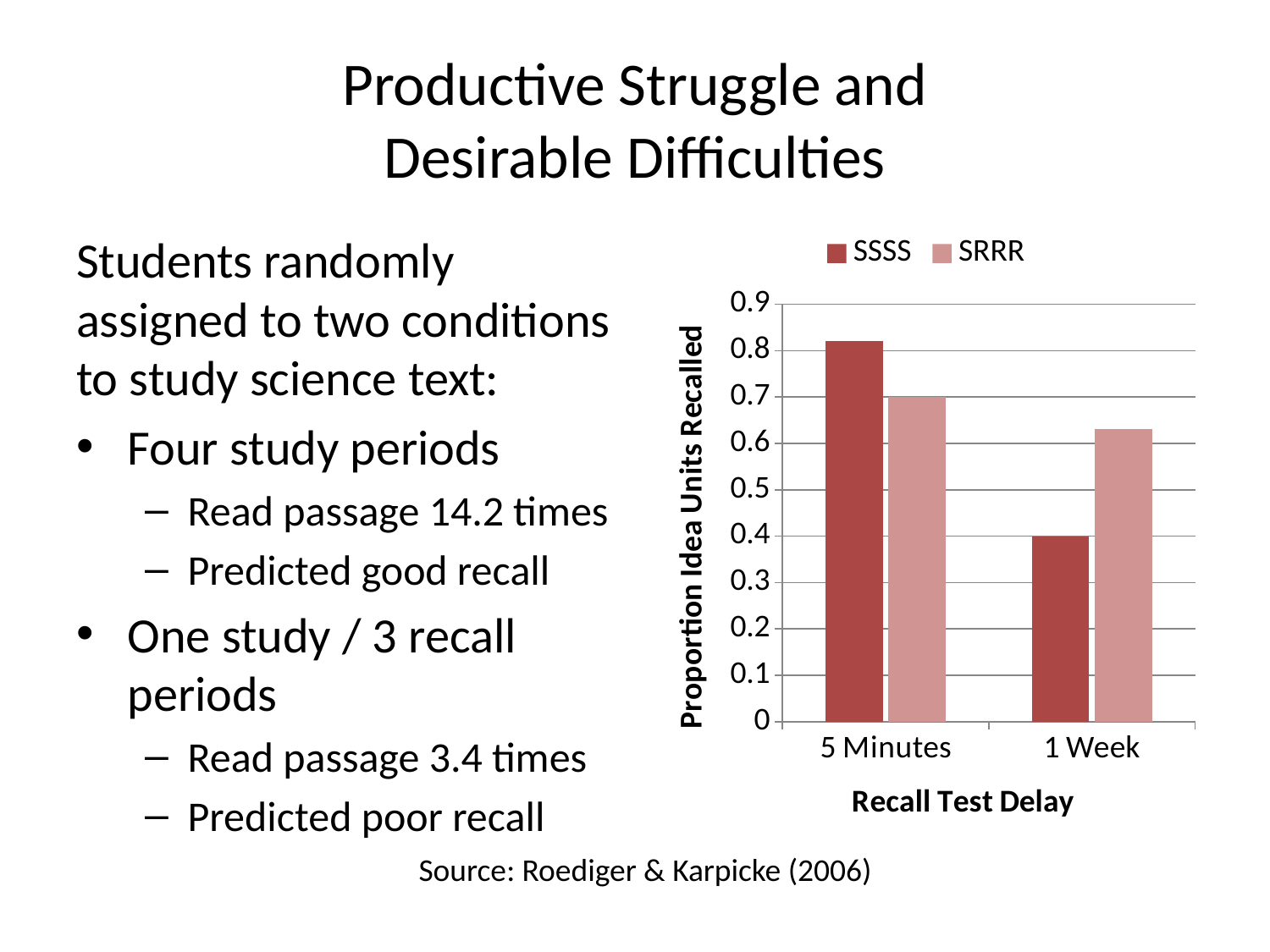
What is the value for SRRR at 5 Minutes? 0.7 At 1 Week, which series has the larger value, SSSS or SRRR? SRRR Is the value for SSSS at 5 Minutes greater or less than 0.8? greater At 5 Minutes, which series has the larger value, SSSS or SRRR? SSSS Is the value for SRRR at 1 Week greater or less than 0.6? greater Is the value for SRRR at 1 Week greater or less than 0.7? less What is the value for SSSS at 1 Week? 0.4 What is the title of the chart's y axis? Proportion Idea Units Recalled Which bar in the chart is the lowest? SSSS at 1 Week How many categories are shown on the x axis of the chart? 2 What kind of chart is shown on the slide? bar chart How many series does the chart legend list? 2